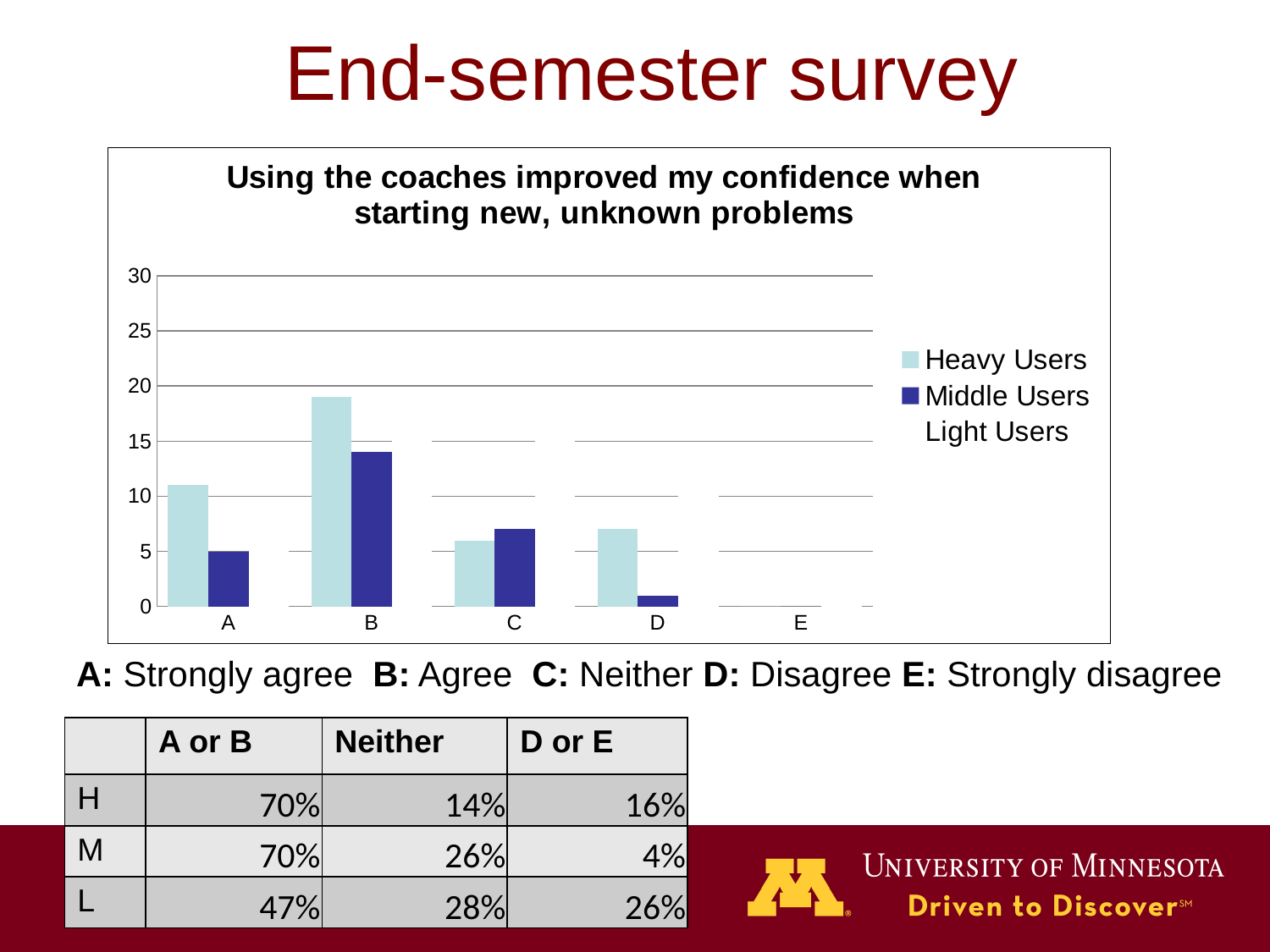
For category A, which series has the larger value, Heavy Users or Middle Users? Heavy Users For category D, which series has the larger value, Heavy Users or Middle Users? Heavy Users Is the Heavy Users value for B greater or less than 15? greater How many series does the chart's legend list? 3 What is the title of the chart? Using the coaches improved my confidence when starting new, unknown problems What kind of chart is shown on the slide? bar chart For which category is the Middle Users bar the tallest? B For which category is the Heavy Users bar the tallest? B Is the Middle Users value for D greater or less than 5? less Is the Middle Users value for B greater or less than 15? less How many categories are shown on the x axis of the chart? 5